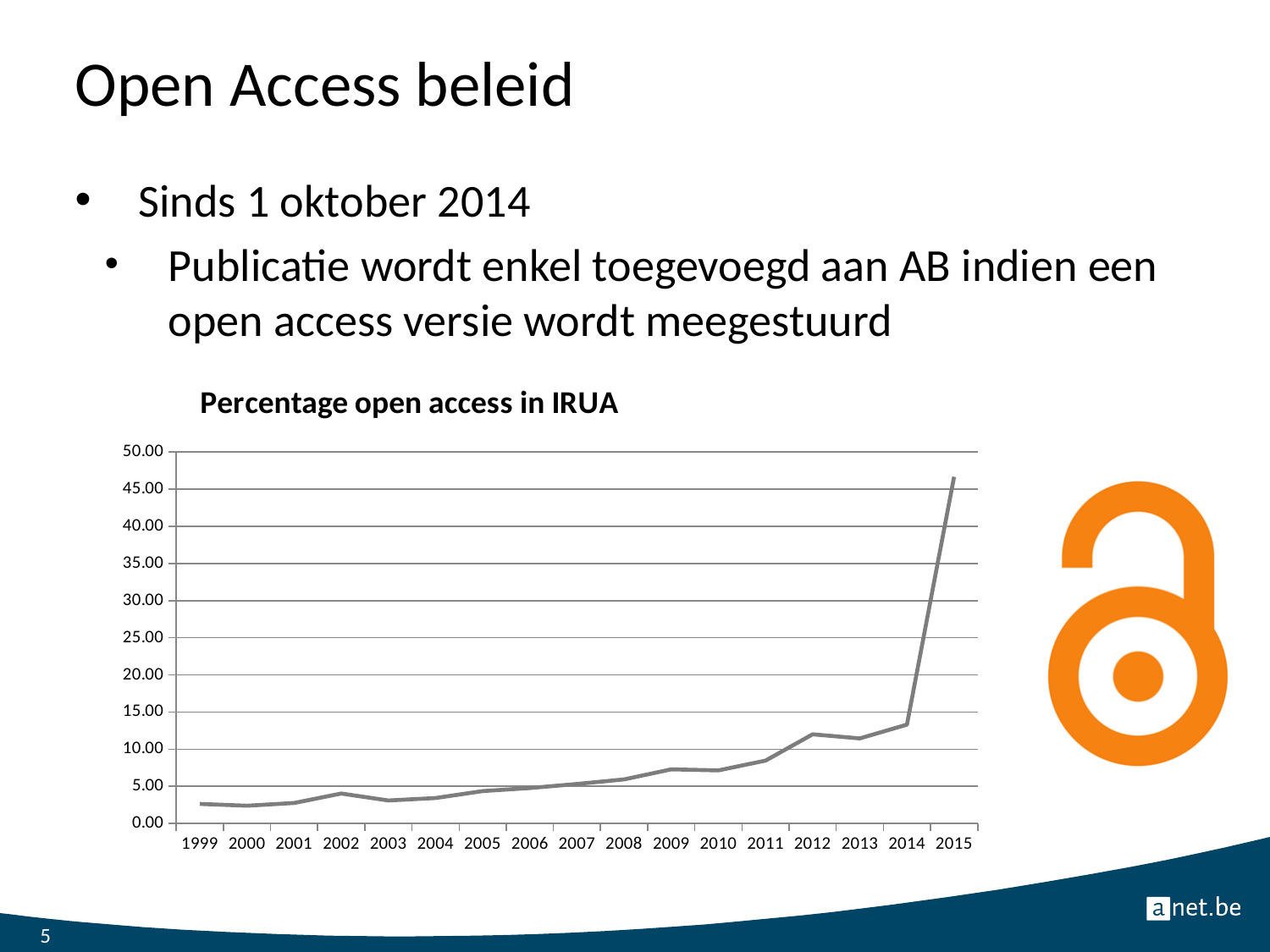
What kind of chart is shown on the slide? line chart Is the value for 2014 greater or less than 15? less Is the value for 2015 greater or less than 40? greater How many years are plotted along the x axis of the chart? 17 Is the value for 1999 greater or less than 5? less Which year has the larger value, 2014 or 2015? 2015 Overall, do the values rise or fall from 1999 to 2015? rise Which year has the highest percentage of open access in IRUA? 2015 What is the title of the chart? Percentage open access in IRUA Which year has the larger value, 2002 or 2003? 2002